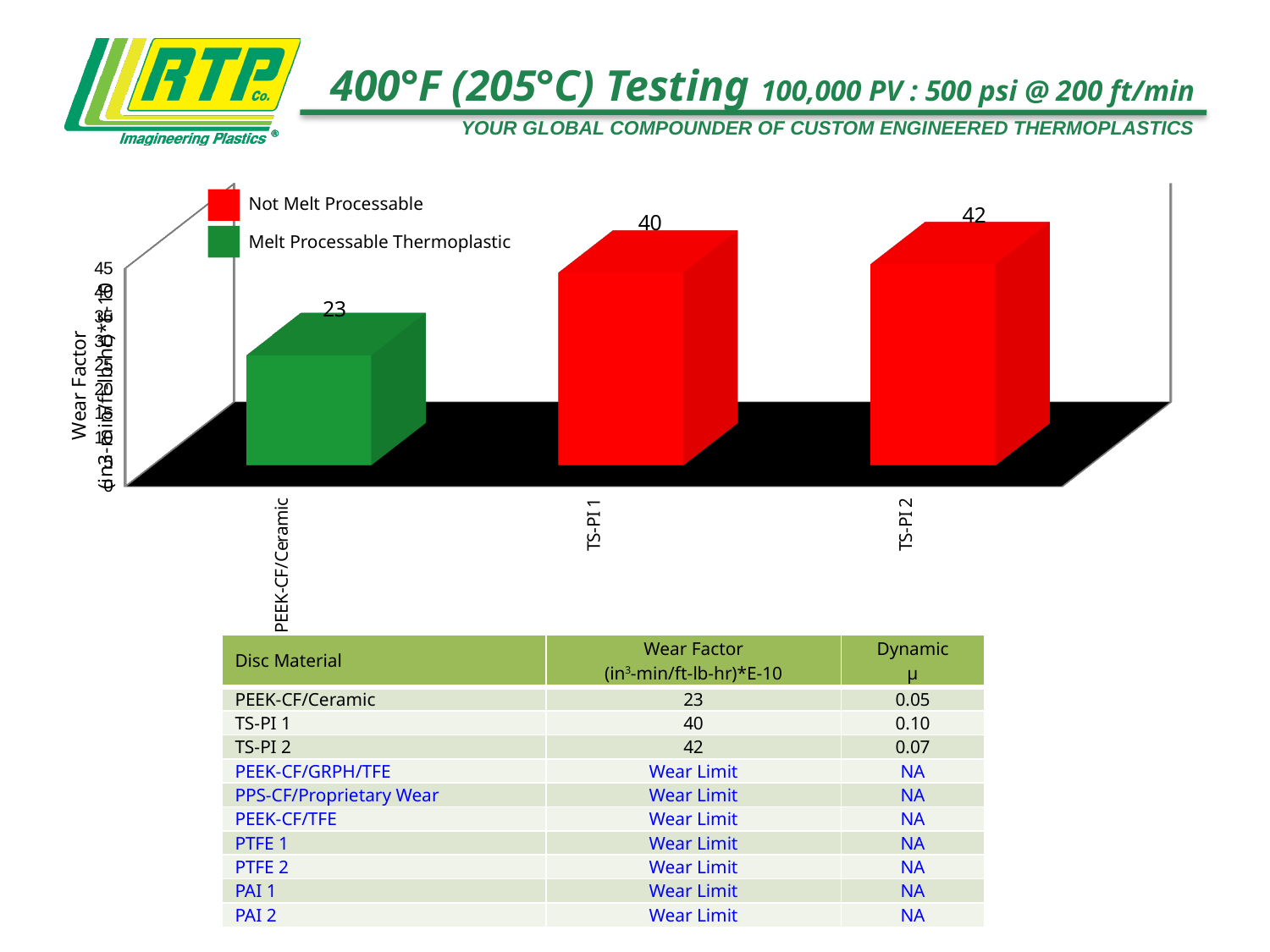
How many entries does the chart legend list? 2 Which has a larger wear factor, PEEK-CF/Ceramic or TS-PI 1? TS-PI 1 Which material has the highest wear factor in the chart? TS-PI 2 What is the difference between the wear factor of TS-PI 2 and TS-PI 1? 2 Which material has the lowest wear factor in the chart? PEEK-CF/Ceramic What is the wear factor value shown for TS-PI 1 in the chart? 40 How many materials are plotted as bars in the chart? 3 What kind of chart is shown on the slide? Bar chart What is the difference between the wear factor of TS-PI 1 and PEEK-CF/Ceramic? 17 What is the wear factor value shown for PEEK-CF/Ceramic in the chart? 23 What is the wear factor value shown for TS-PI 2 in the chart? 42 According to the legend, what does the green bar colour represent? Melt Processable Thermoplastic